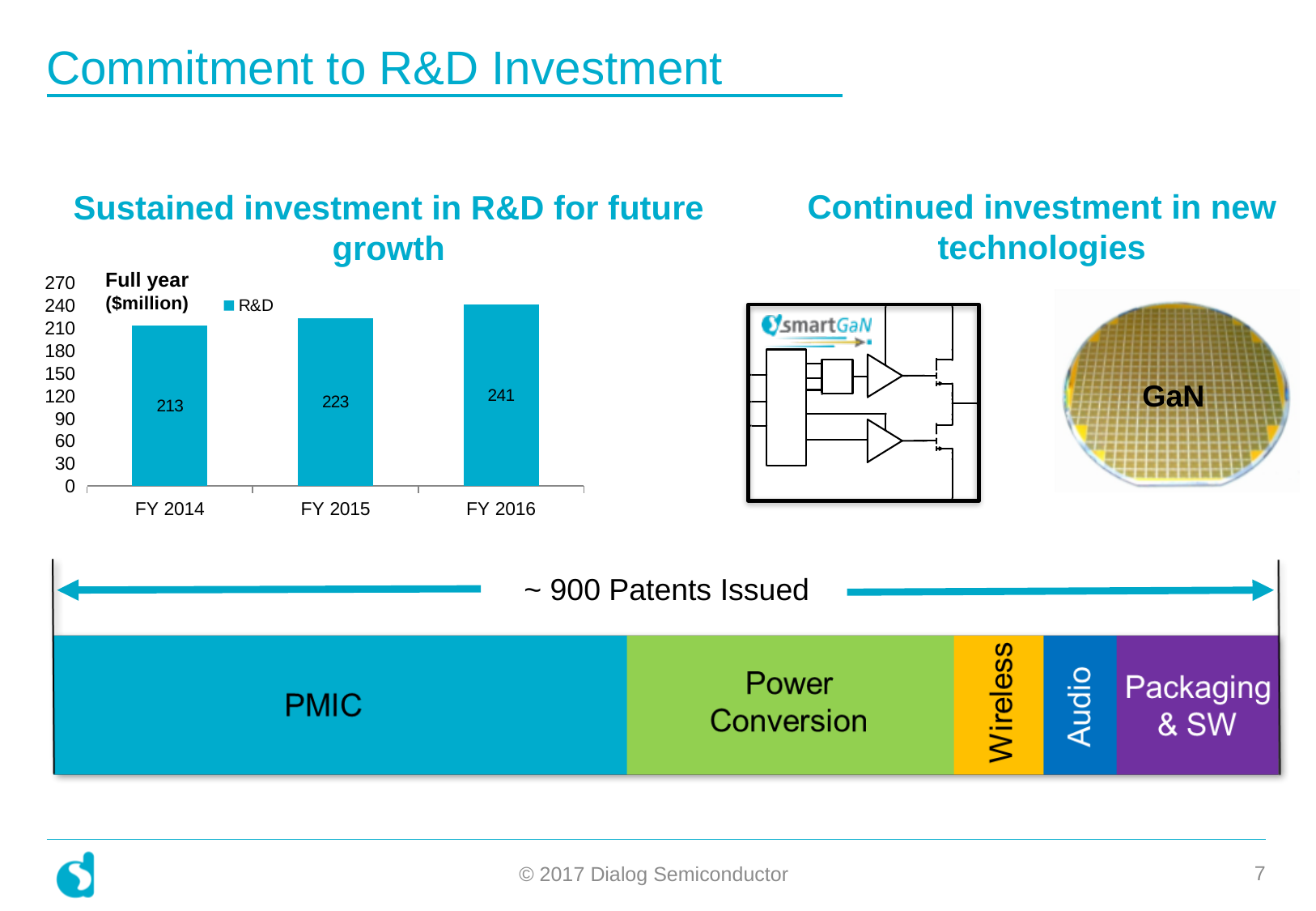
What is the R&D value for FY 2015? 223 What is the difference between the R&D values for FY 2016 and FY 2014? 28 What is the difference between the R&D values for FY 2015 and FY 2014? 10 How many series does the legend of the R&D chart list? 1 How many fiscal years are shown on the x axis of the R&D chart? 3 Do the R&D values rise or fall from FY 2014 to FY 2016? rise What is the R&D value for FY 2016? 241 Which fiscal year has the lowest R&D value? FY 2014 Which is larger, the R&D value for FY 2015 or FY 2016? FY 2016 Which fiscal year has the highest R&D value? FY 2016 What is the R&D value for FY 2014? 213 What kind of chart is used to show the R&D investment? bar chart